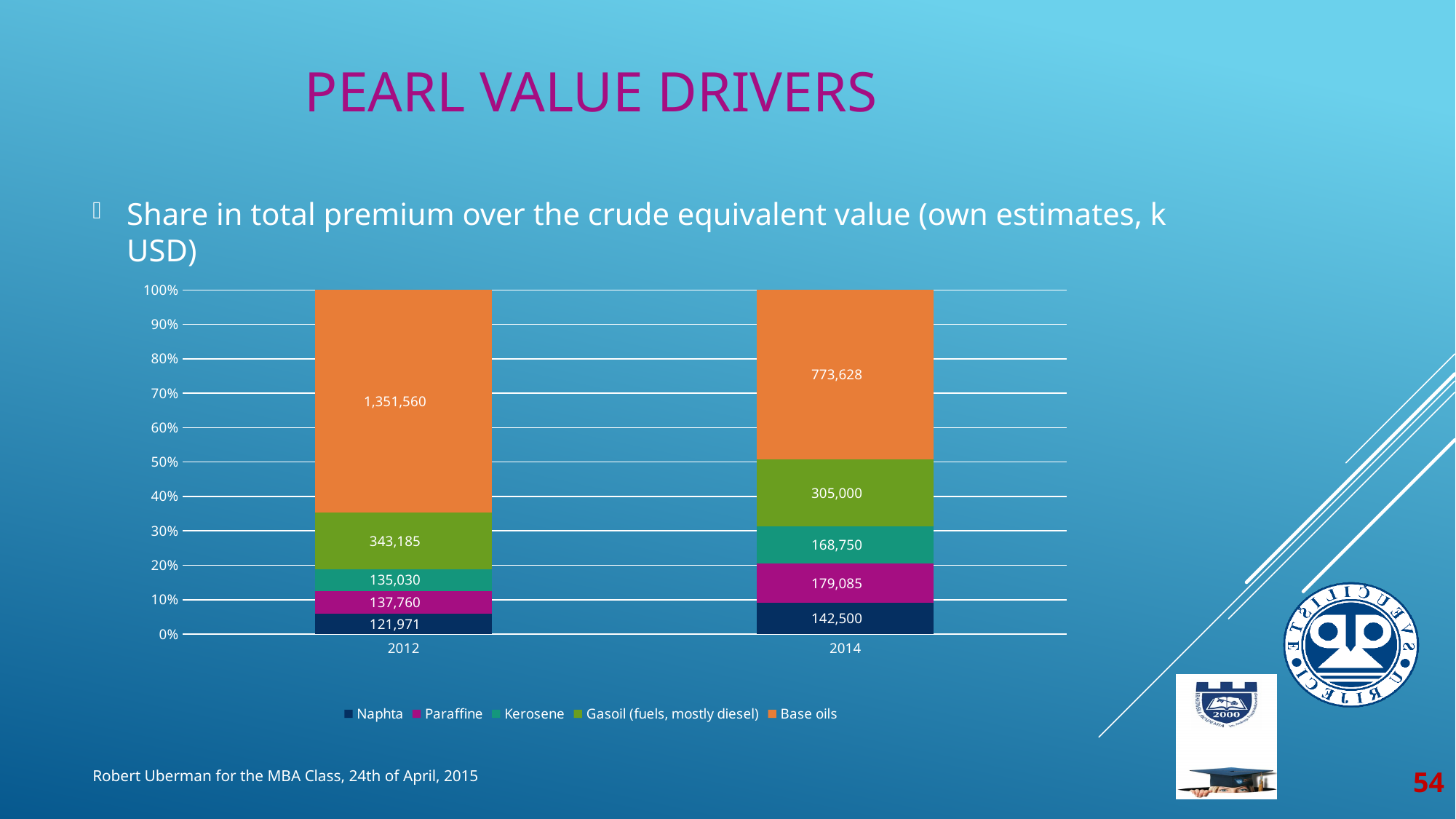
How many series does the legend list? 5 Which series has the lowest value in 2012? Naphta What type of chart is shown on the slide? Stacked bar chart What is the total of the stacked bar for 2014? 1,568,963 How many years (categories) are shown on the x axis? 2 What is the value for Paraffine in 2014? 179,085 What is the value for Kerosene in 2012? 135,030 What is the difference between the Base oils value in 2012 and in 2014? 577,932 What is the value for Base oils in 2012? 1,351,560 What is the value for Gasoil (fuels, mostly diesel) in 2014? 305,000 Which is larger: the Naphta value in 2012 or in 2014? 2014 Which series has the highest value in 2014? Base oils